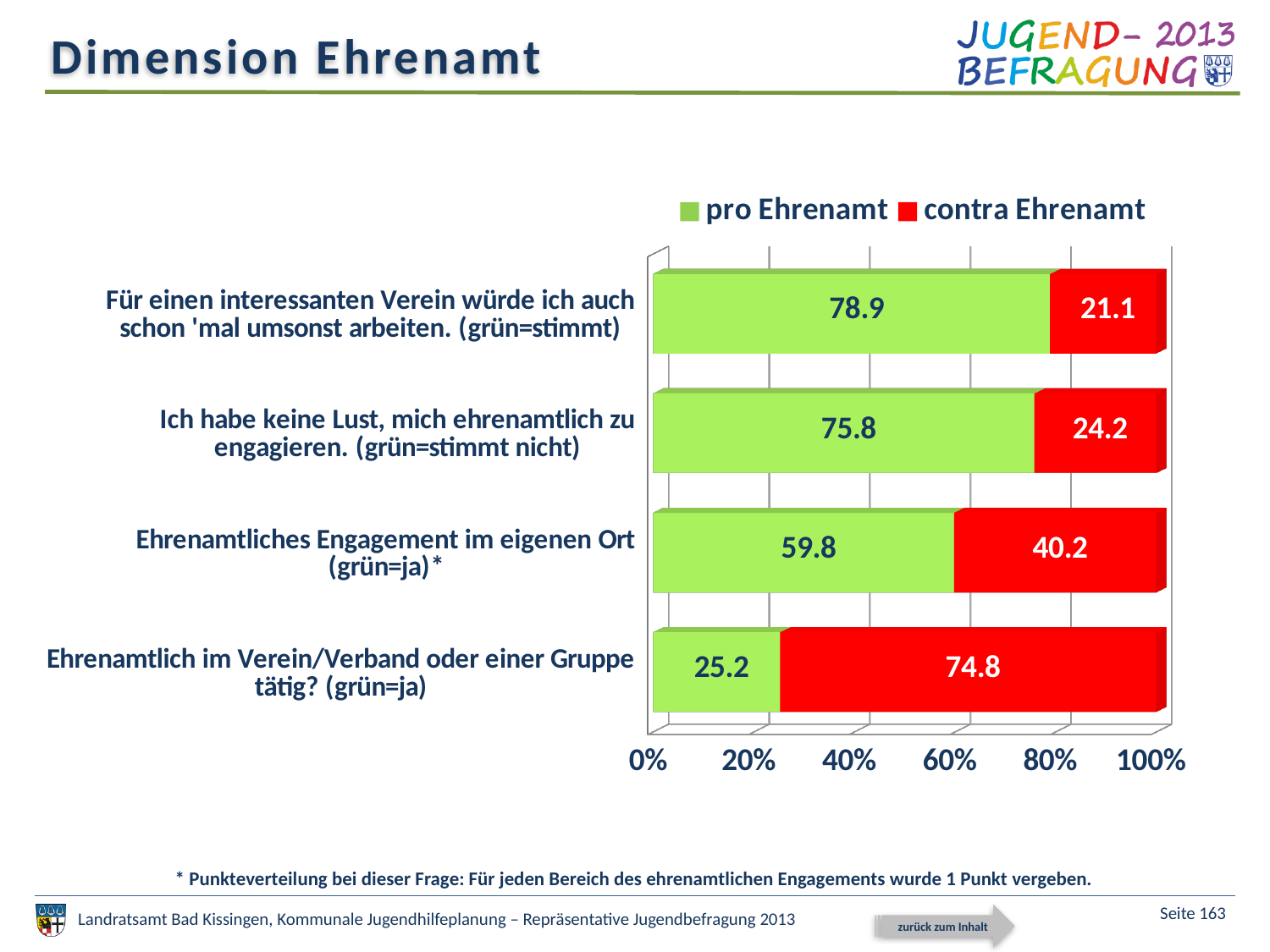
Which is larger: the 'contra Ehrenamt' value for 'Ehrenamtliches Engagement im eigenen Ort' or for 'Ehrenamtlich im Verein/Verband oder einer Gruppe tätig?'? Ehrenamtlich im Verein/Verband oder einer Gruppe tätig? (grün=ja) What is the difference between the 'pro Ehrenamt' values for 'Für einen interessanten Verein würde ich auch schon 'mal umsonst arbeiten' and 'Ich habe keine Lust, mich ehrenamtlich zu engagieren'? 3.1 What kind of chart is shown on the slide? Stacked bar chart What is the 'contra Ehrenamt' value for 'Ehrenamtliches Engagement im eigenen Ort'? 40.2 How many categories are shown in the chart? 4 Which category has the highest 'pro Ehrenamt' value? Für einen interessanten Verein würde ich auch schon 'mal umsonst arbeiten. (grün=stimmt) What is the total of the stacked bar for 'Ehrenamtliches Engagement im eigenen Ort'? 100 How many series does the legend list? 2 What is the 'pro Ehrenamt' value for 'Ehrenamtlich im Verein/Verband oder einer Gruppe tätig?'? 25.2 What is the 'pro Ehrenamt' value for 'Für einen interessanten Verein würde ich auch schon 'mal umsonst arbeiten'? 78.9 What is the 'contra Ehrenamt' value for 'Ich habe keine Lust, mich ehrenamtlich zu engagieren'? 24.2 Which category has the lowest 'pro Ehrenamt' value? Ehrenamtlich im Verein/Verband oder einer Gruppe tätig? (grün=ja)